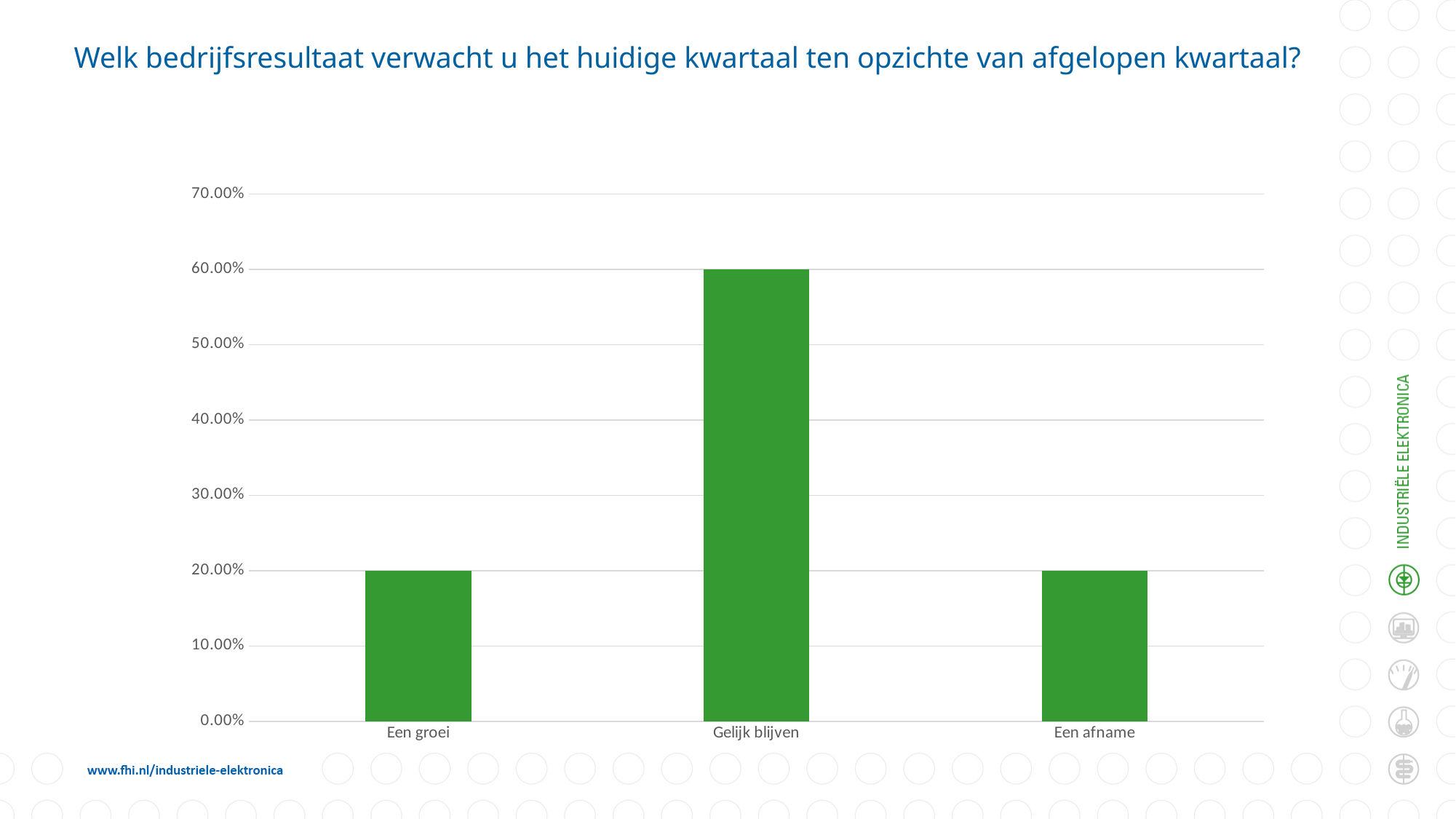
What colour are the bars in the chart? green What is the title of the chart? Welk bedrijfsresultaat verwacht u het huidige kwartaal ten opzichte van afgelopen kwartaal? What is the value for Een afname? 20.00% Is the value for Een groei greater or less than 30.00%? less What kind of chart is shown on the slide? bar chart What is the value for Gelijk blijven? 60.00% How many categories are shown on the x axis? 3 Which is larger, the value for Gelijk blijven or the value for Een afname? Gelijk blijven What is the value for Een groei? 20.00% What is the difference between the values for Gelijk blijven and Een groei? 40.00% Is the value for Gelijk blijven greater or less than 50.00%? greater Which category has the highest value? Gelijk blijven